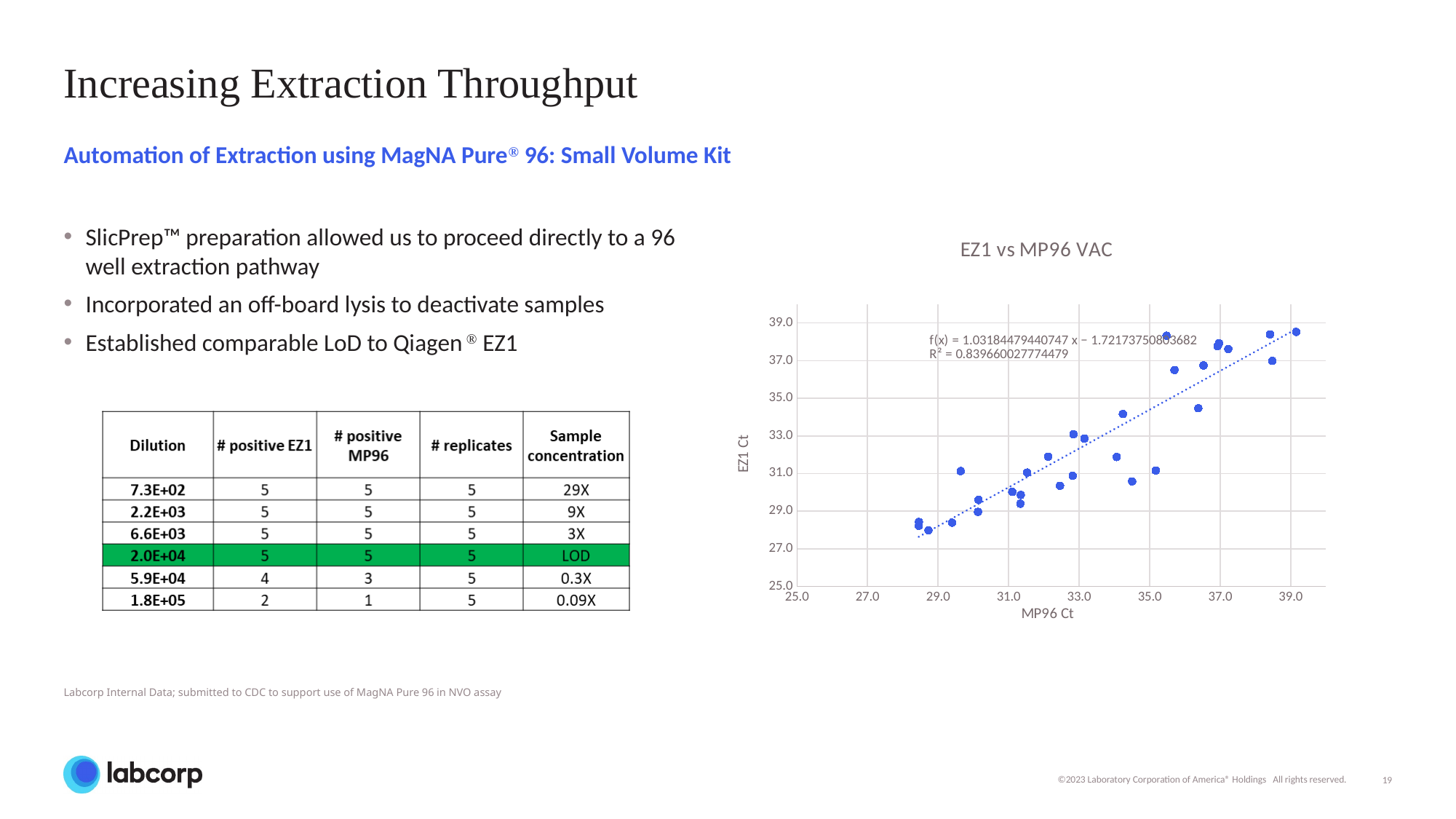
Is the lowest EZ1 Ct value plotted on the chart greater or less than 29.0? less What is the label of the x axis of the chart? MP96 Ct Do the EZ1 Ct values generally rise or fall as MP96 Ct increases along the x axis? Rise Is the highest EZ1 Ct value plotted on the chart greater or less than 37.0? greater Is the lowest MP96 Ct value plotted on the chart greater or less than 29.0? less What is the slope of the trendline equation printed on the chart? 1.03184479440747 What is the title of the chart on the slide? EZ1 vs MP96 VAC What R² value is printed on the chart for the trendline? 0.839660027774479 What kind of chart is shown on the slide? Scatter chart